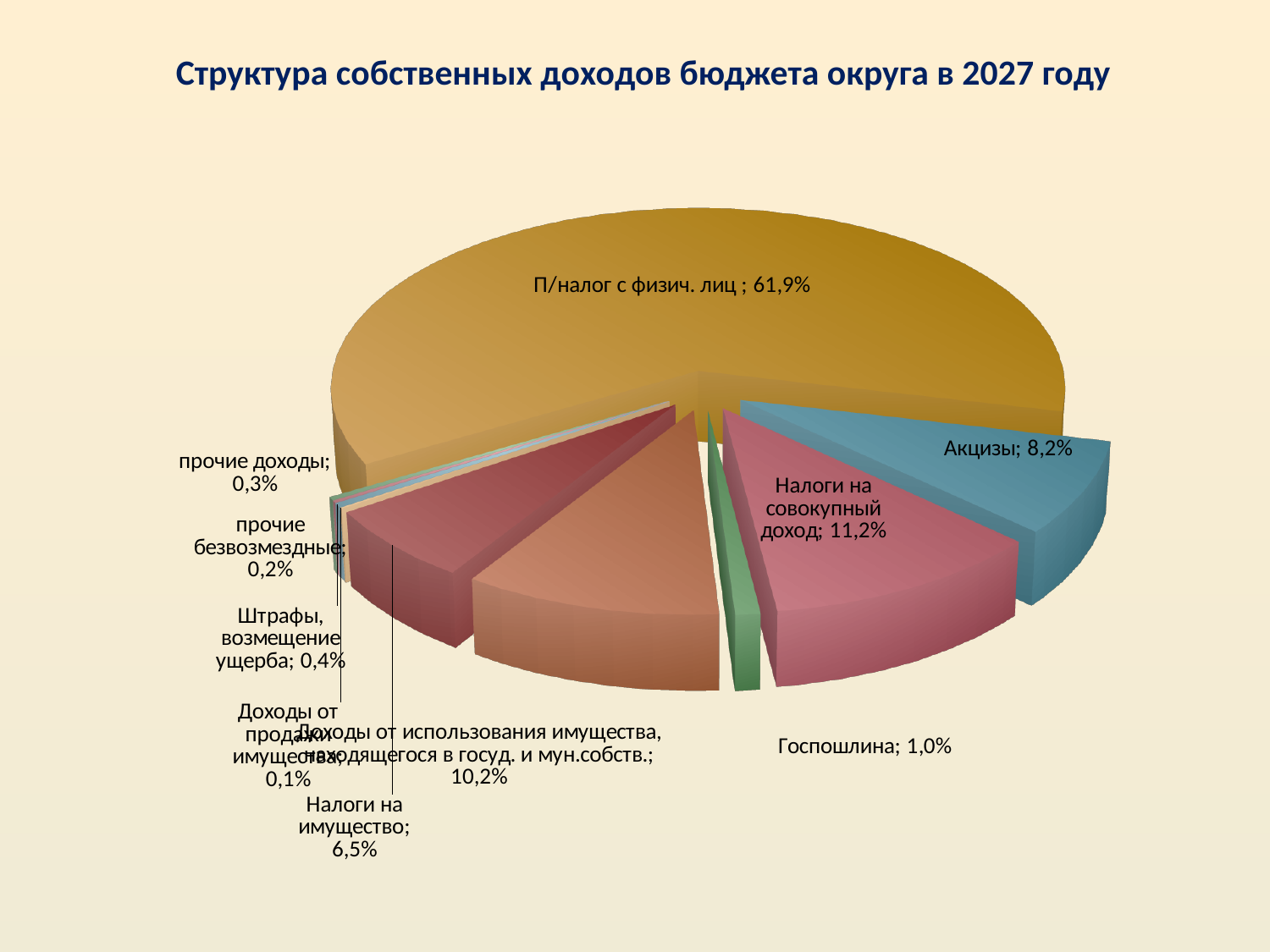
What is the value shown for Налоги на совокупный доход? 11,2% What share of the pie does П/налог с физич. лиц account for? 61,9% Which is larger, the share for Акцизы or the share for Налоги на имущество? Акцизы What kind of chart is shown on the slide? Pie chart What is the title of the chart? Структура собственных доходов бюджета округа в 2027 году What is the value shown for Налоги на имущество? 6,5% What is the value shown for Акцизы? 8,2% What is the value shown for Госпошлина? 1,0% What is the difference between the shares of П/налог с физич. лиц and Налоги на совокупный доход? 50,7% What is the value shown for Доходы от использования имущества, находящегося в госуд. и мун.собств.? 10,2% Which category has the largest share of the pie? П/налог с физич. лиц What is the value shown for Штрафы, возмещение ущерба? 0,4%